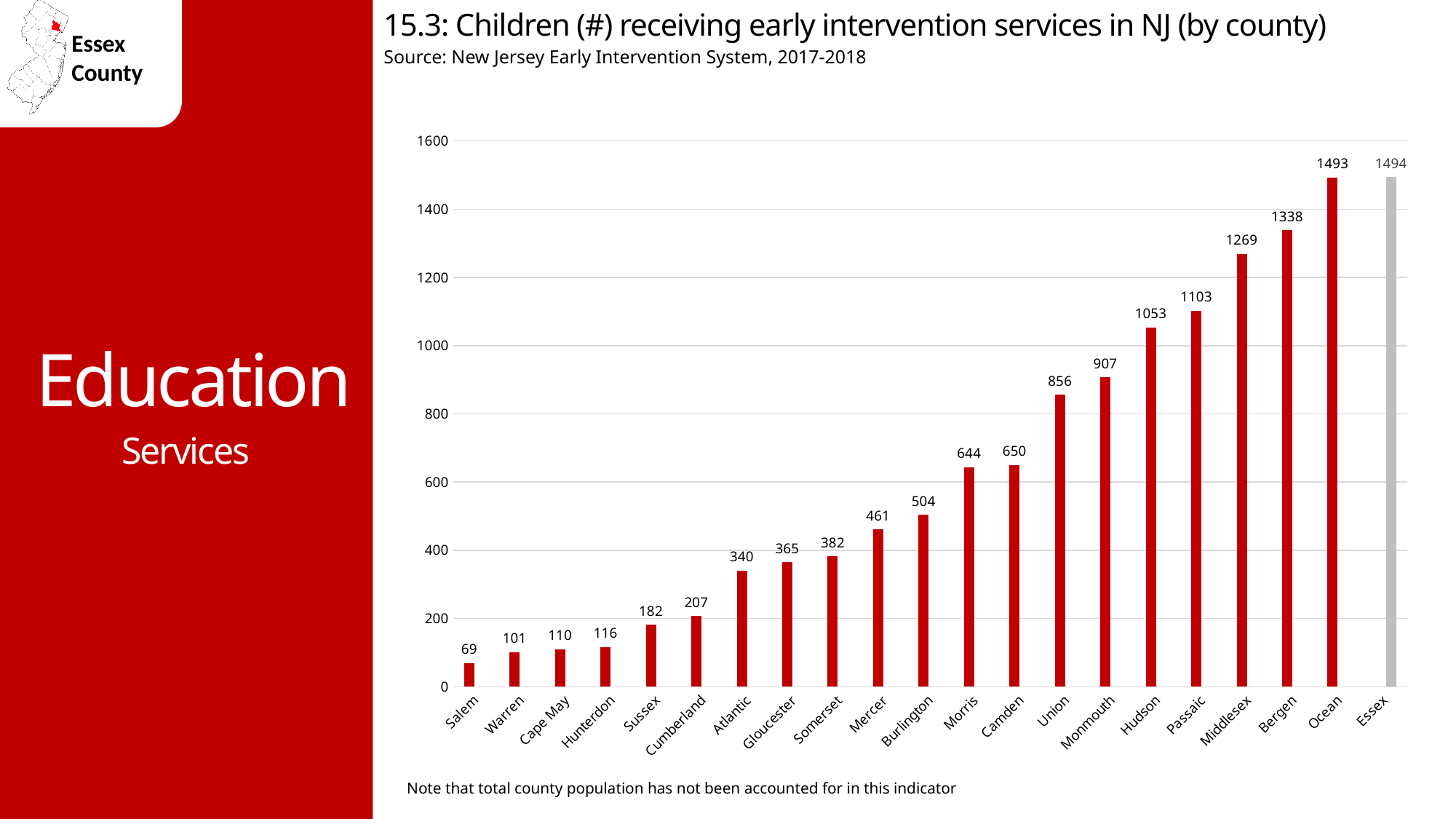
Which has a larger value, Union or Monmouth? Monmouth Which county has the highest number of children receiving early intervention services? Essex How many counties are shown on the chart? 21 What is the value shown for Hudson? 1053 What kind of chart is shown on the slide? Bar chart What is the value shown for Salem? 69 Is the value for Passaic greater or less than 1000? greater What is the difference between the values for Camden and Morris? 6 Which county has the lowest number of children receiving early intervention services? Salem Do the values rise or fall moving from left to right along the x axis? Rise How many children received early intervention services in Essex County? 1494 What is the difference between the values for Bergen and Middlesex? 69